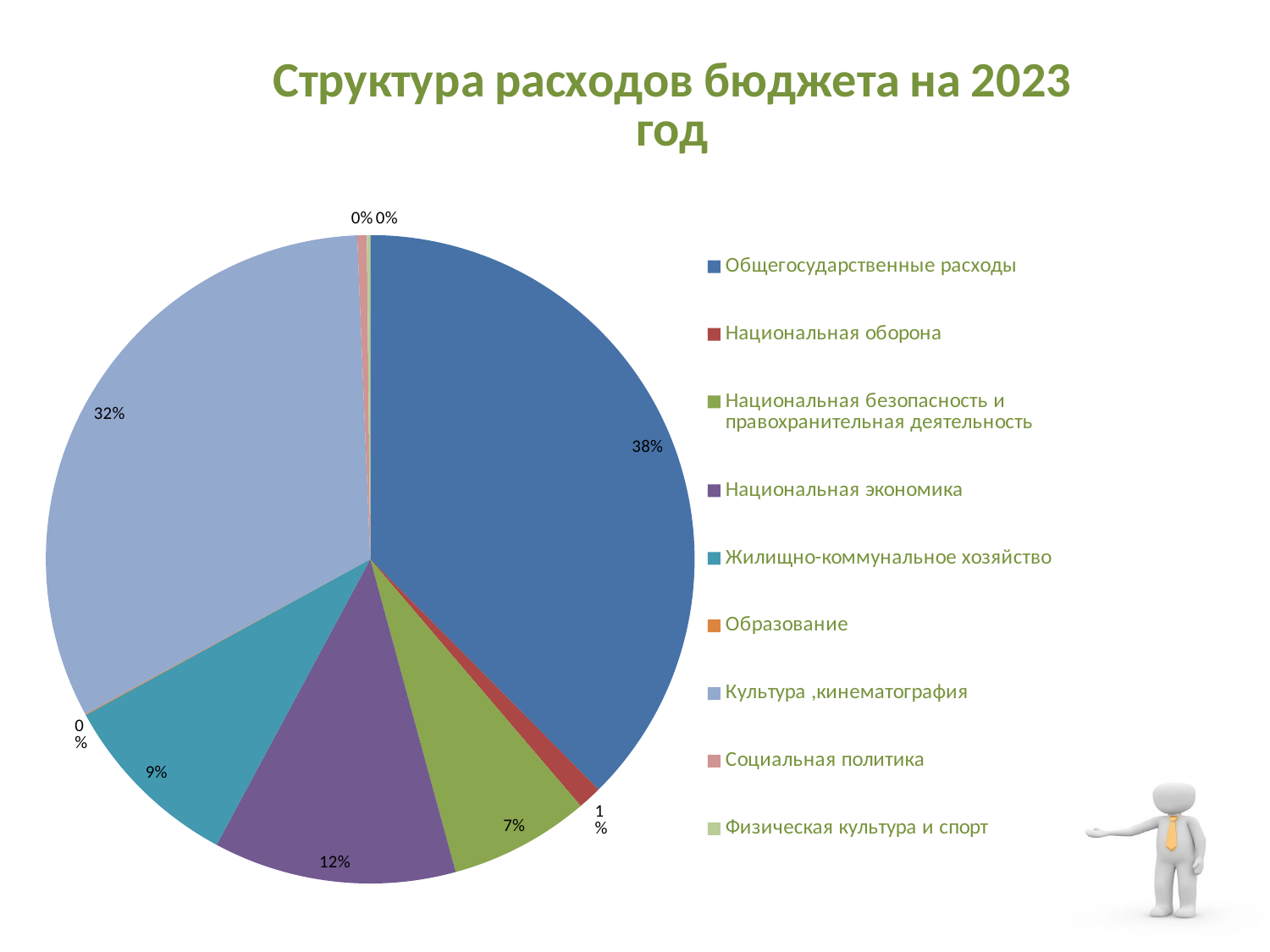
What share of the pie is Общегосударственные расходы? 38% What share of the pie is Национальная экономика? 12% How many entries does the legend list? 9 What share of the pie is Культура ,кинематография? 32% What kind of chart is shown on the slide? pie chart What is the difference in percentage points between Общегосударственные расходы and Культура ,кинематография? 6 Which category has the largest share of the pie? Общегосударственные расходы What is the title of the chart? Структура расходов бюджета на 2023 год Which is larger, the share for Национальная экономика or the share for Жилищно-коммунальное хозяйство? Национальная экономика